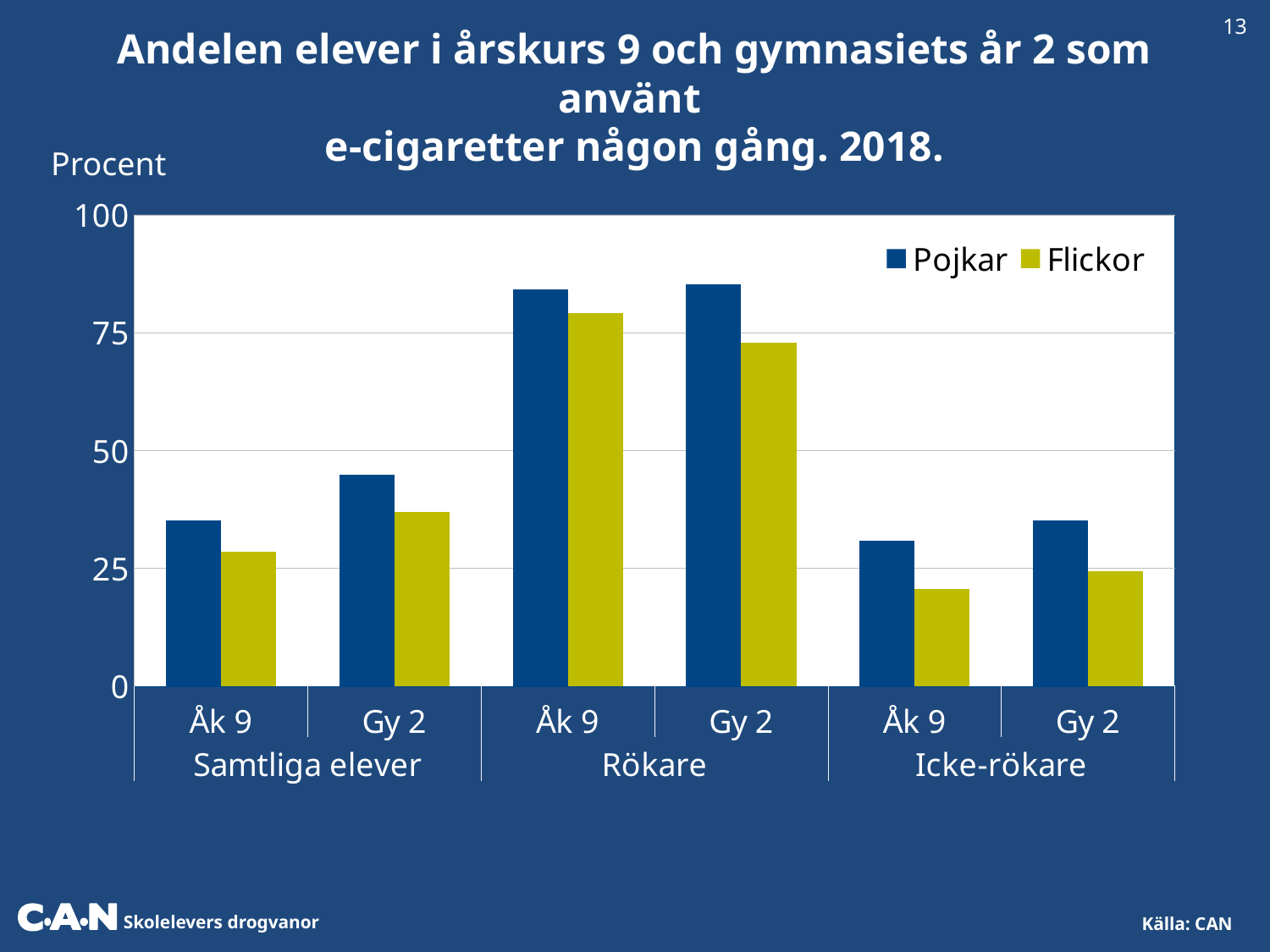
Is the Flickor value for Åk 9 among Icke-rökare greater or less than 25? less Is the Pojkar value for Gy 2 among Rökare greater or less than 75? greater What kind of chart is shown on the slide? bar chart How many category groups (pairs of bars) are plotted along the x axis? 6 Is the Pojkar value for Gy 2 among Samtliga elever greater or less than 50? less What are the two series named in the legend? Pojkar and Flickor How many series does the legend list? 2 Which category has the lowest Flickor value? Åk 9, Icke-rökare For Gy 2 among Rökare, which is larger, the Pojkar value or the Flickor value? Pojkar Which category has the highest Flickor value? Åk 9, Rökare What is the label shown on the vertical axis? Procent